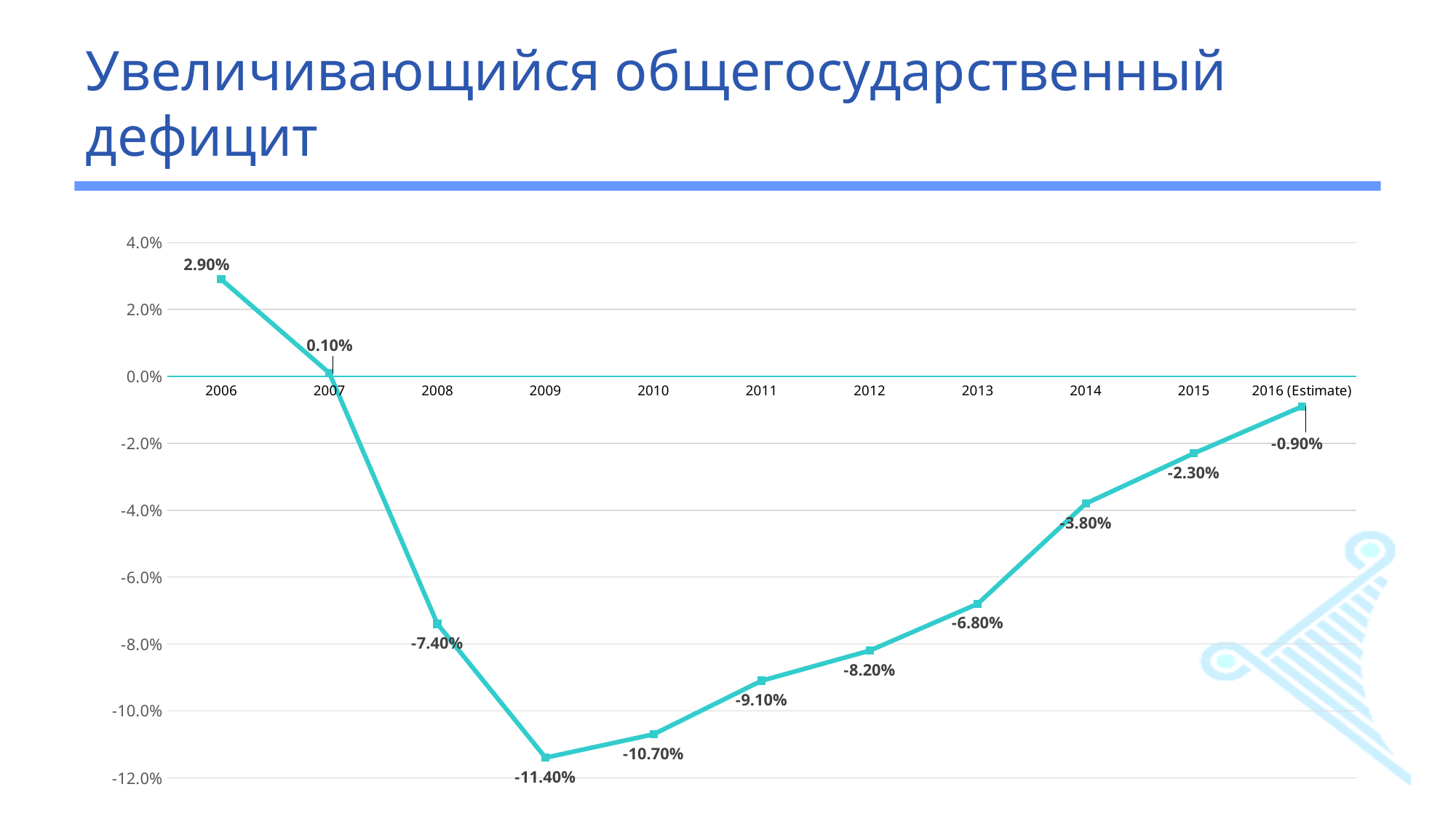
Do the values rise or fall from 2009 to 2016 (Estimate)? rise What is the value for 2013? -6.80% What is the value for 2009? -11.40% What is the value for 2006? 2.90% How many data points are plotted on the chart? 11 What is the value for 2016 (Estimate)? -0.90% Which is larger, the value for 2010 or the value for 2011? 2011 Which year has the highest value? 2006 What type of chart is shown on the slide? line chart Which year has the lowest value? 2009 What is the difference between the values for 2006 and 2007? 2.80% What is the title of the slide? Увеличивающийся общегосударственный дефицит